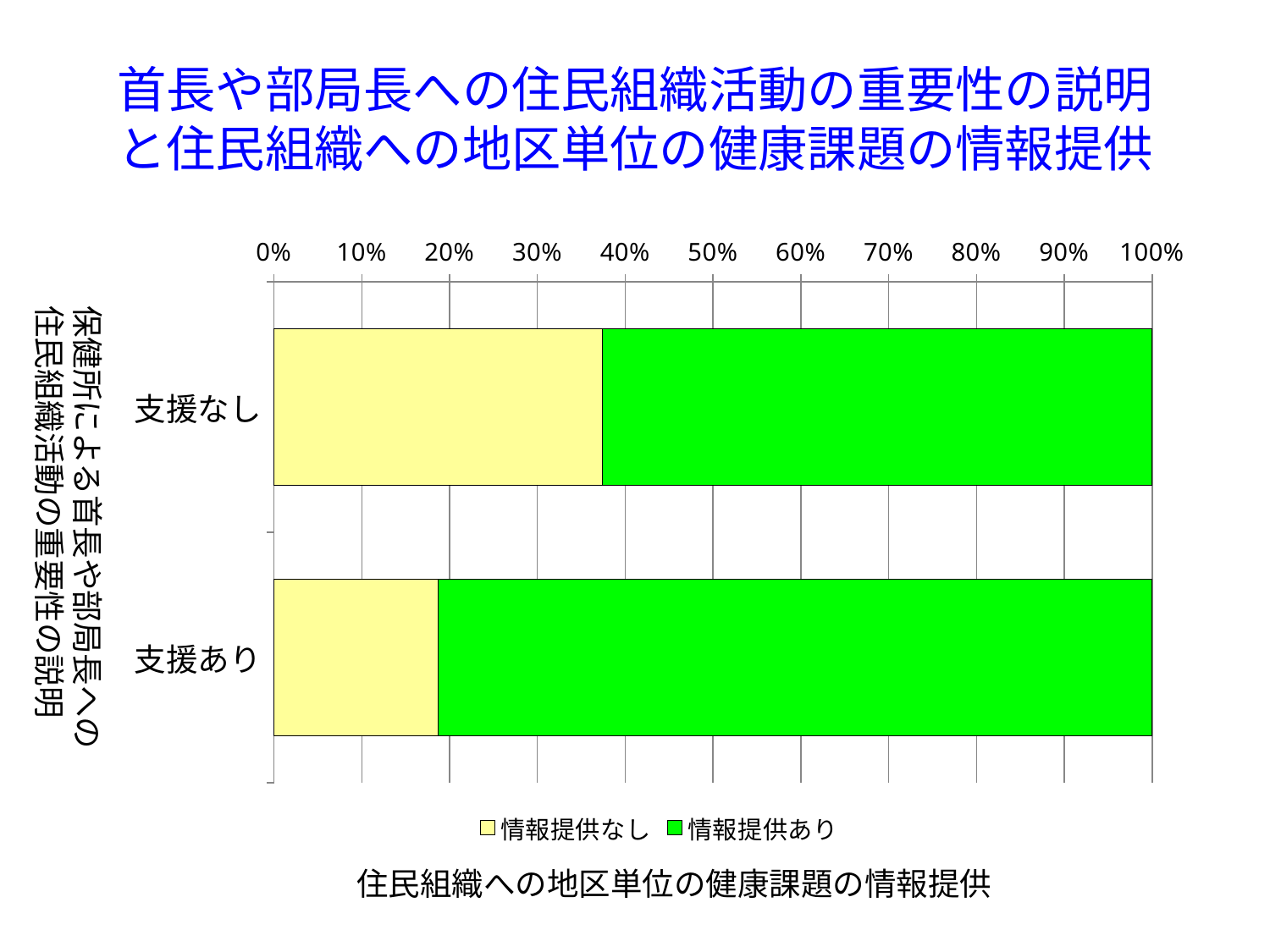
What kind of chart is shown on the slide? bar chart Which category has the larger 情報提供あり share, 支援なし or 支援あり? 支援あり Is the 情報提供なし share for 支援あり greater or less than 30%? less Is the 情報提供なし share for 支援なし greater or less than 30%? greater Is the 情報提供あり share for 支援あり greater or less than 70%? greater What colour represents the 情報提供あり series in the chart? green How many categories are shown on the vertical axis of the chart? 2 Which category has the larger 情報提供なし share, 支援なし or 支援あり? 支援なし How many series does the chart legend list? 2 Which two series are listed in the chart legend? 情報提供なし and 情報提供あり